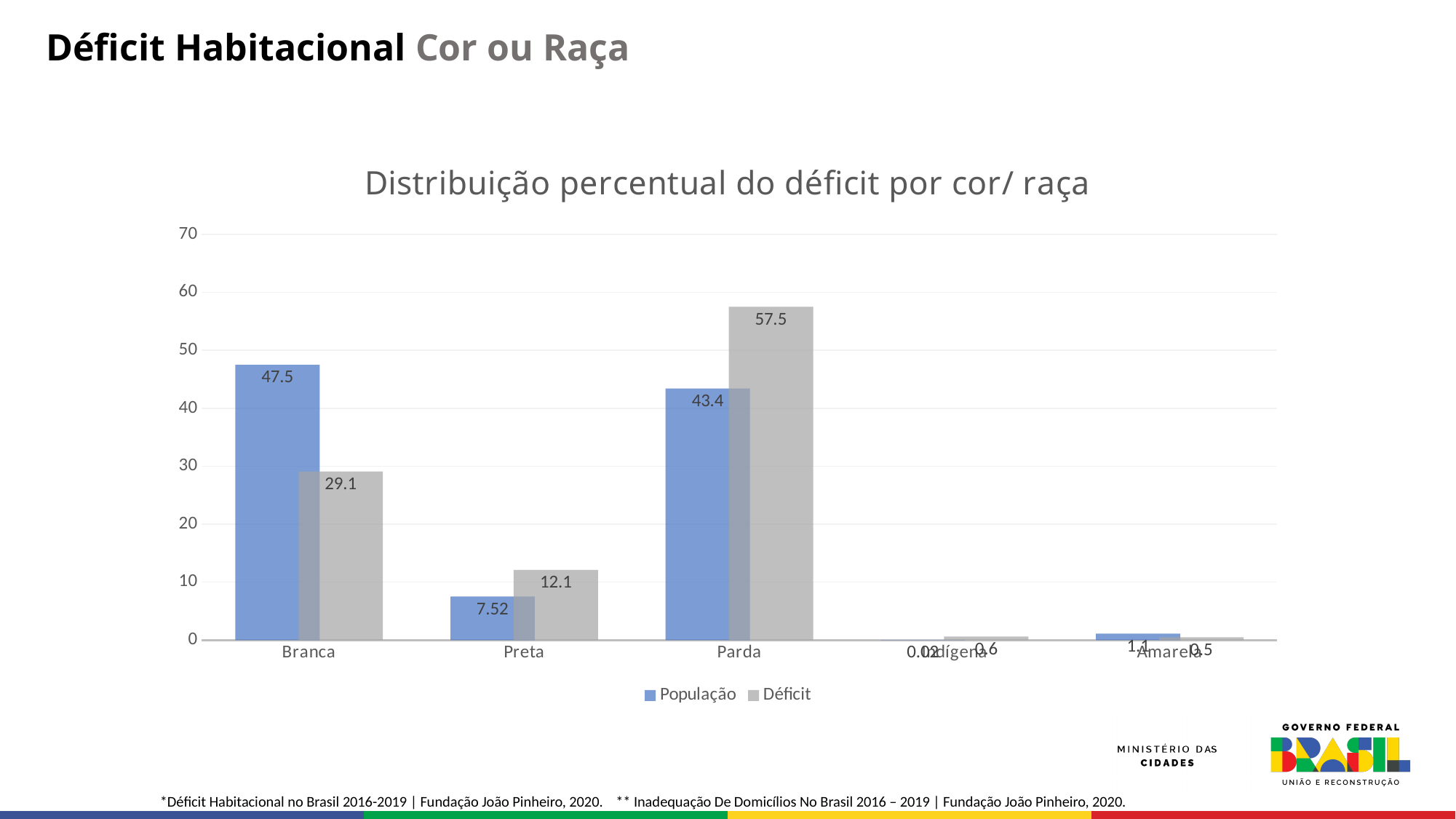
How many series does the legend list? 2 Which category has the highest Déficit value? Parda What is the difference between the População and Déficit values for Branca? 18.4 How many categories are shown on the x axis? 5 Which category has the highest População value? Branca What is the Déficit value for Preta? 12.1 Which is larger, the Déficit value for Branca or the Déficit value for Parda? Parda What is the difference between the Déficit and População values for Parda? 14.1 What is the População value for Preta? 7.52 What kind of chart is shown on the slide? Bar chart What is the Déficit value for Parda? 57.5 What is the População value for Branca? 47.5